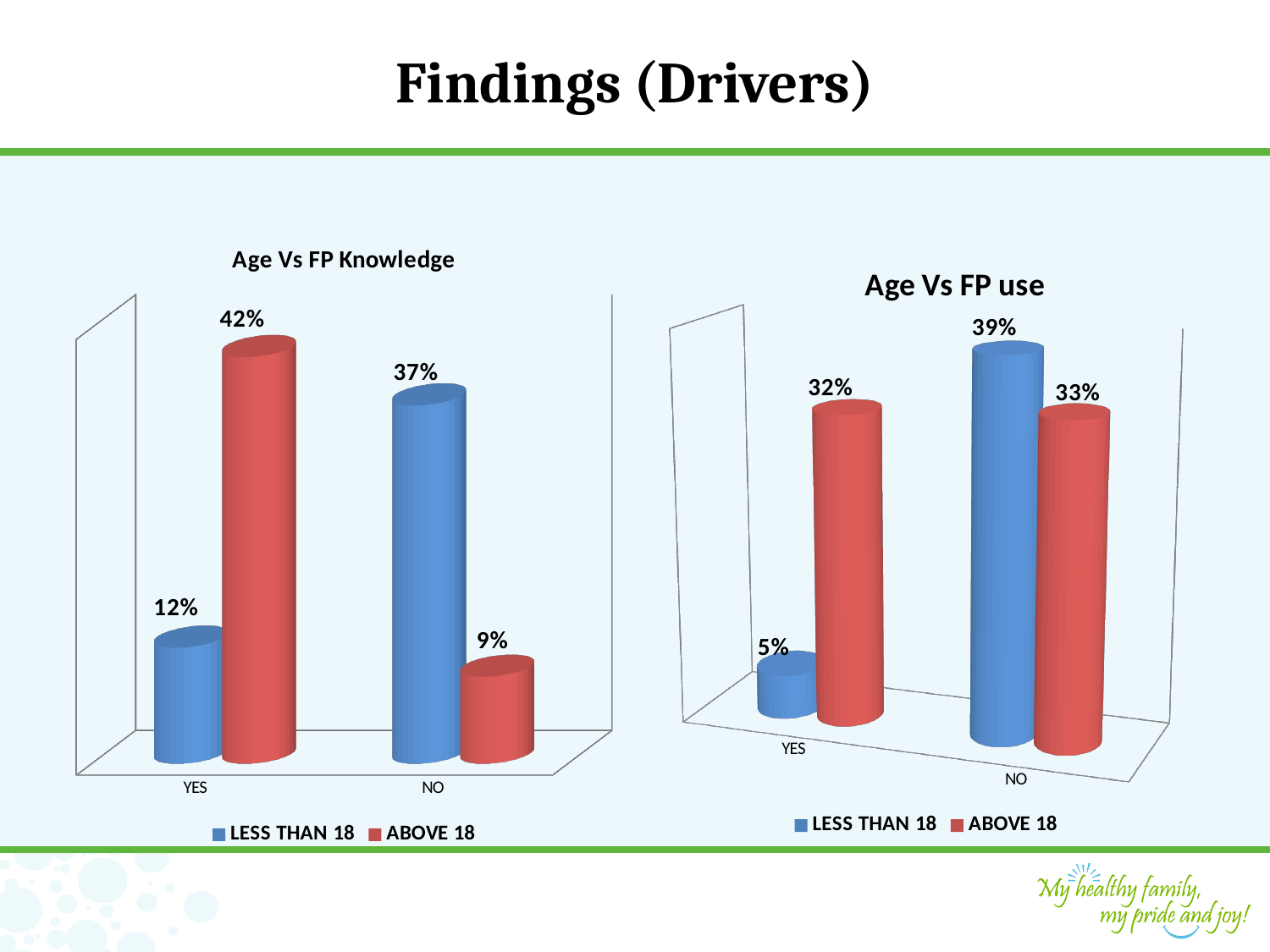
In the 'Age Vs FP use' chart, which bar has the lowest value? LESS THAN 18, YES (5%) In the 'Age Vs FP Knowledge' chart, what is the value for LESS THAN 18 in the YES category? 12% In the 'Age Vs FP use' chart, what is the value for ABOVE 18 in the YES category? 32% How many categories are shown on the x axis of the 'Age Vs FP use' chart? 2 In the 'Age Vs FP use' chart, which is larger in the YES category: LESS THAN 18 or ABOVE 18? ABOVE 18 In the 'Age Vs FP Knowledge' chart, what is the value for ABOVE 18 in the NO category? 9% In the 'Age Vs FP Knowledge' chart, what is the difference between the ABOVE 18 and LESS THAN 18 values in the YES category? 30% In the 'Age Vs FP use' chart, what is the difference between the LESS THAN 18 and ABOVE 18 values in the NO category? 6% In the 'Age Vs FP use' chart, what is the value for LESS THAN 18 in the NO category? 39% How many series does the legend of the 'Age Vs FP Knowledge' chart list? 2 In the 'Age Vs FP Knowledge' chart, which bar has the highest value? ABOVE 18, YES (42%) What kind of chart is the 'Age Vs FP Knowledge' chart? Bar chart